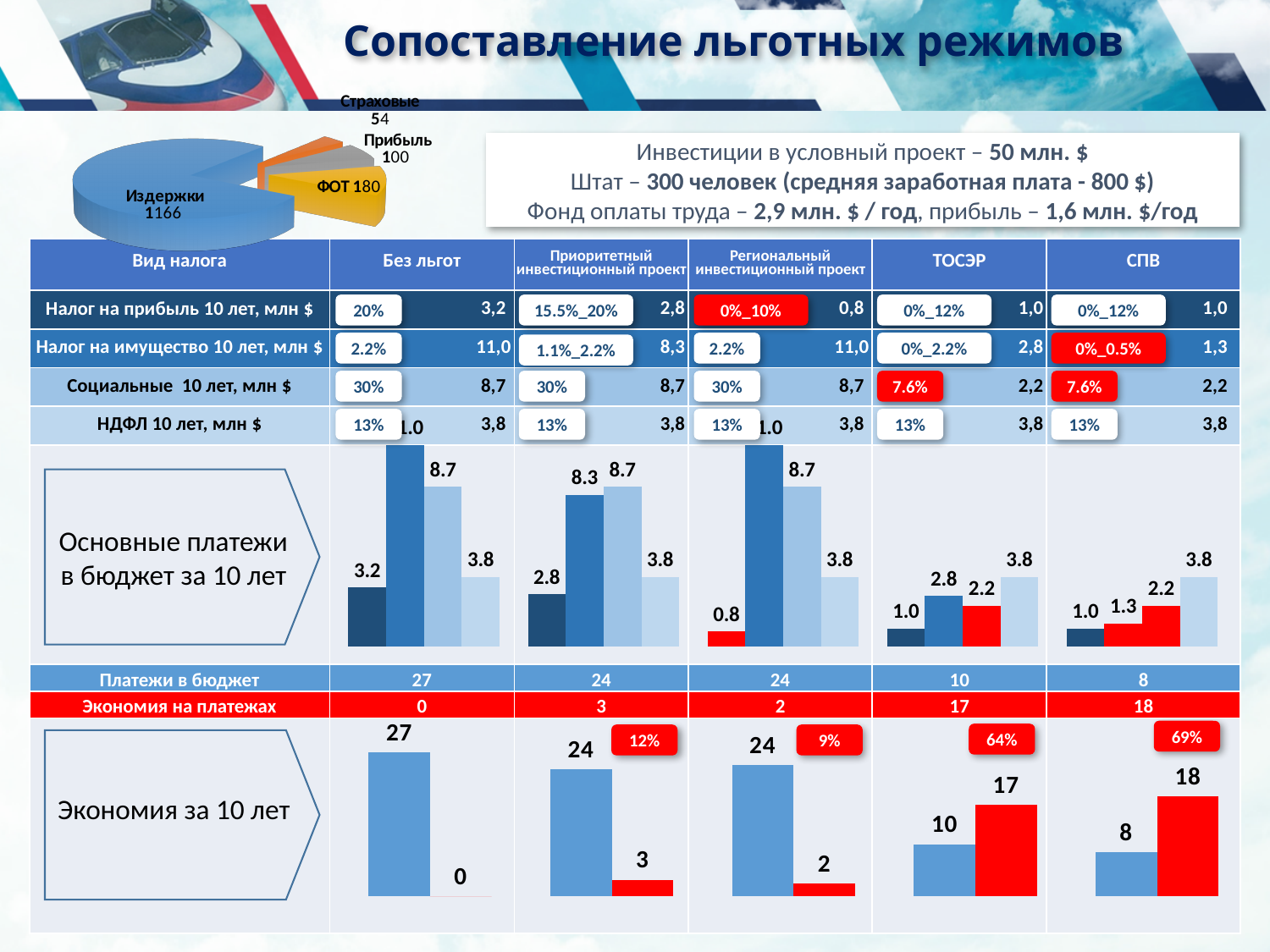
In the 'Основные платежи в бюджет за 10 лет' bar chart for the 'Без льгот' column, what is the highest value shown? 11.0 What type of chart is shown in the top-left corner of the slide? pie chart What type of chart is used in the 'Экономия за 10 лет' row? bar chart In the pie chart at the top left, what is the value for ФОТ? 180 How many slices does the pie chart at the top left have? 4 In the pie chart at the top left, what is the value for Издержки? 1166 In the 'Экономия за 10 лет' bar chart for the 'Приоритетный инвестиционный проект' column, which bar is larger, the blue bar or the red bar? the blue bar (24) In the pie chart at the top left, which category has the smallest slice? Страховые In the 'Экономия за 10 лет' bar chart for the 'ТОСЭР' column, what is the value of the red bar? 17 In the pie chart at the top left, which category has the largest slice? Издержки In the 'Экономия за 10 лет' bar chart for the 'СПВ' column, what is the difference between the red bar (18) and the blue bar (8)? 10 In the 'Основные платежи в бюджет за 10 лет' bar chart for the 'Региональный инвестиционный проект' column, what is the lowest value shown? 0.8